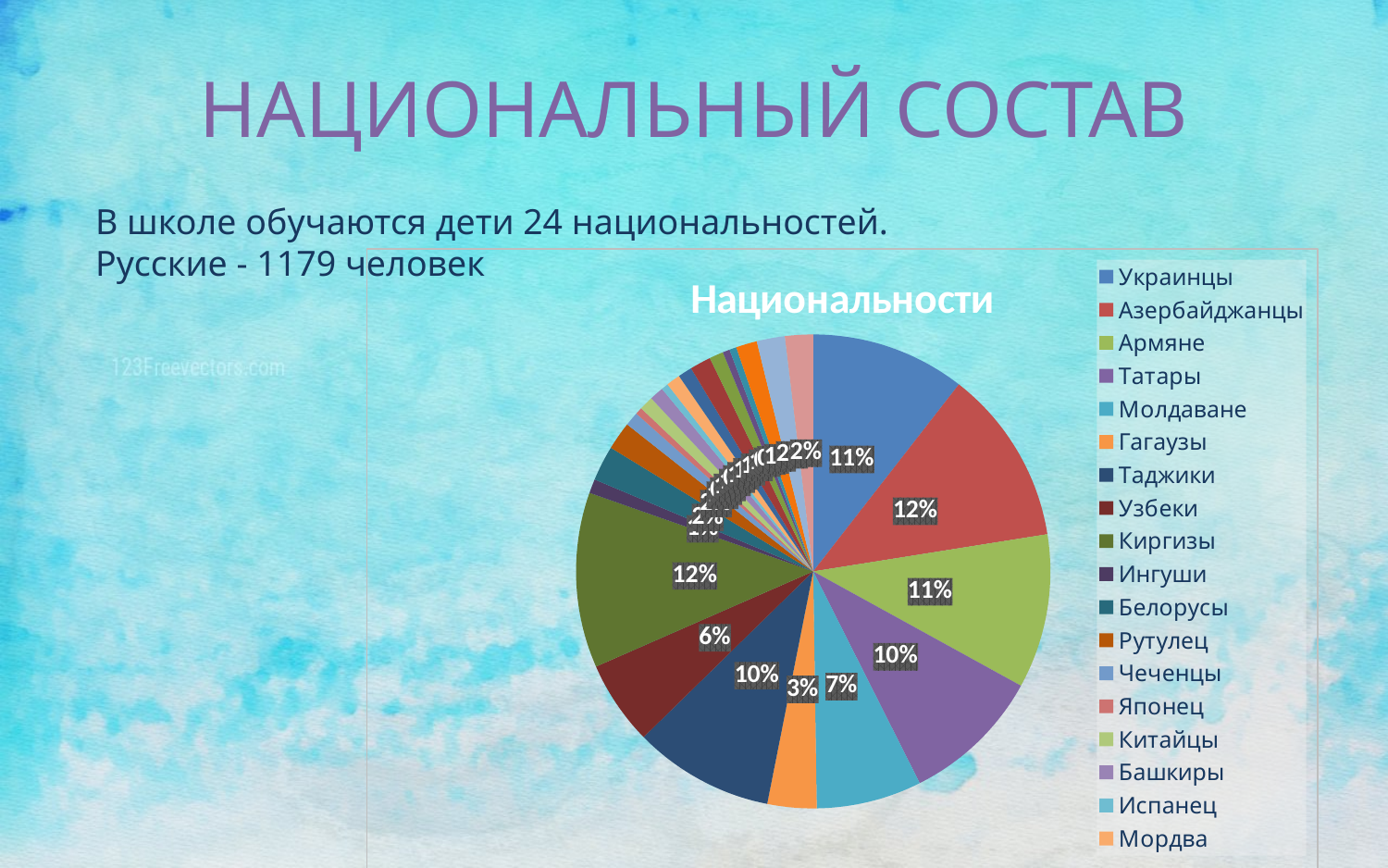
What share of the pie is Таджики? 10% What share of the pie is Украинцы? 11% What share of the pie is Узбеки? 6% Which slice is larger, Азербайджанцы or Гагаузы? Азербайджанцы What share of the pie is Татары? 10% What share of the pie is Армяне? 11% What is the difference between the shares of Киргизы and Узбеки? 6% What is the title of the chart? Национальности What share of the pie is Азербайджанцы? 12% What share of the pie is Молдаване? 7% What kind of chart is shown on the slide? pie chart What share of the pie is Гагаузы? 3%